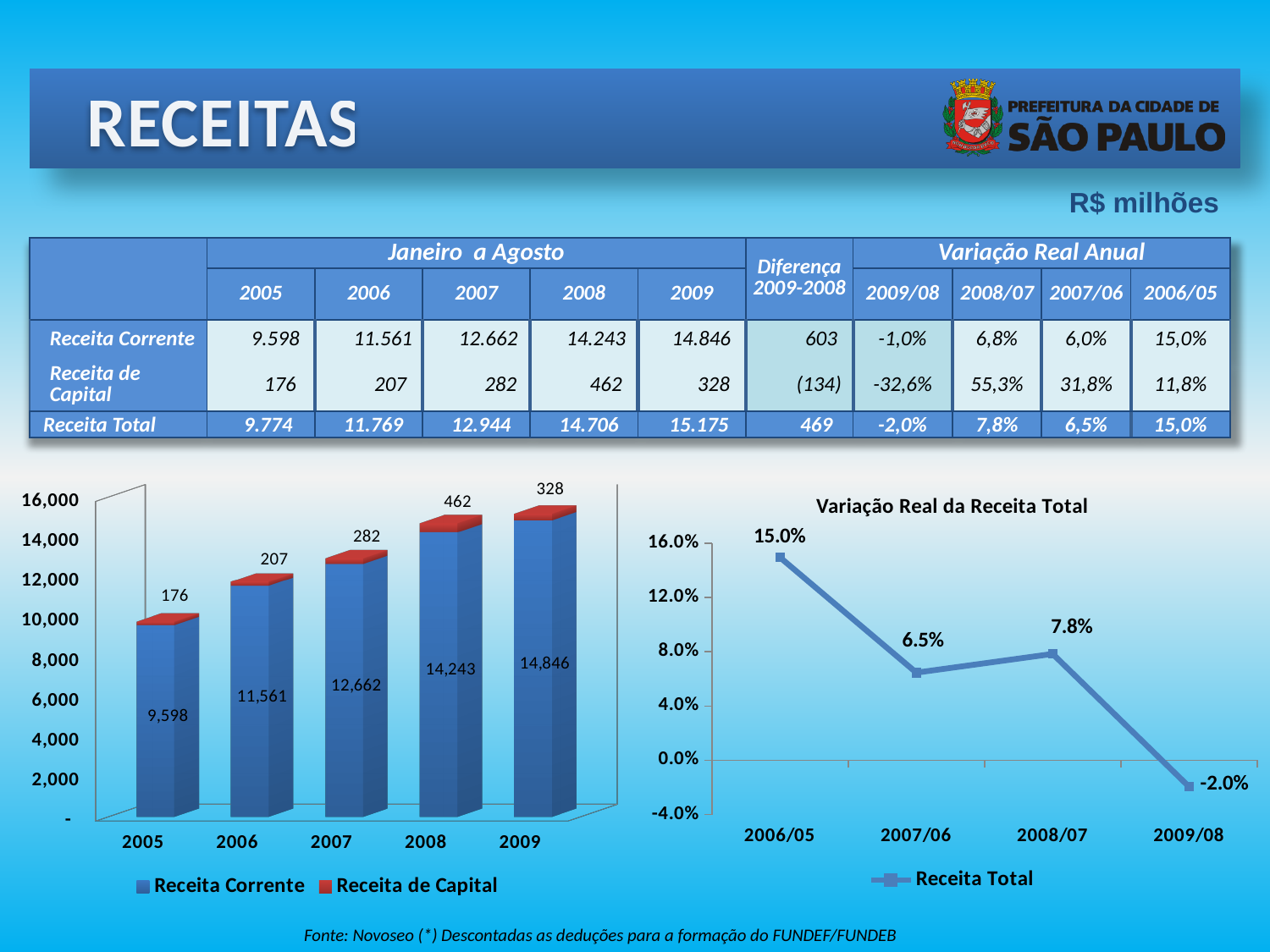
In the stacked bar chart on the left, what is the difference between Receita Corrente in 2009 and in 2008? 603 What kind of chart is 'Variação Real da Receita Total'? line chart In the stacked bar chart on the left, what is the value of Receita Corrente for 2009? 14,846 In the stacked bar chart on the left, does Receita Corrente rise or fall from 2005 to 2009? rise In the chart titled 'Variação Real da Receita Total', which is larger: the value for 2007/06 or 2008/07? 2008/07 In the stacked bar chart on the left, which year has the highest Receita de Capital? 2008 In the stacked bar chart on the left, what is the value of Receita de Capital for 2008? 462 In the chart titled 'Variação Real da Receita Total', which period has the lowest value? 2009/08 In the stacked bar chart on the left, how many series does the legend list? 2 In the stacked bar chart on the left, what is the total of the stacked bar for 2005? 9,774 In the chart titled 'Variação Real da Receita Total', what is the value for 2007/06? 6.5% In the stacked bar chart on the left, which year has the lowest Receita Corrente? 2005